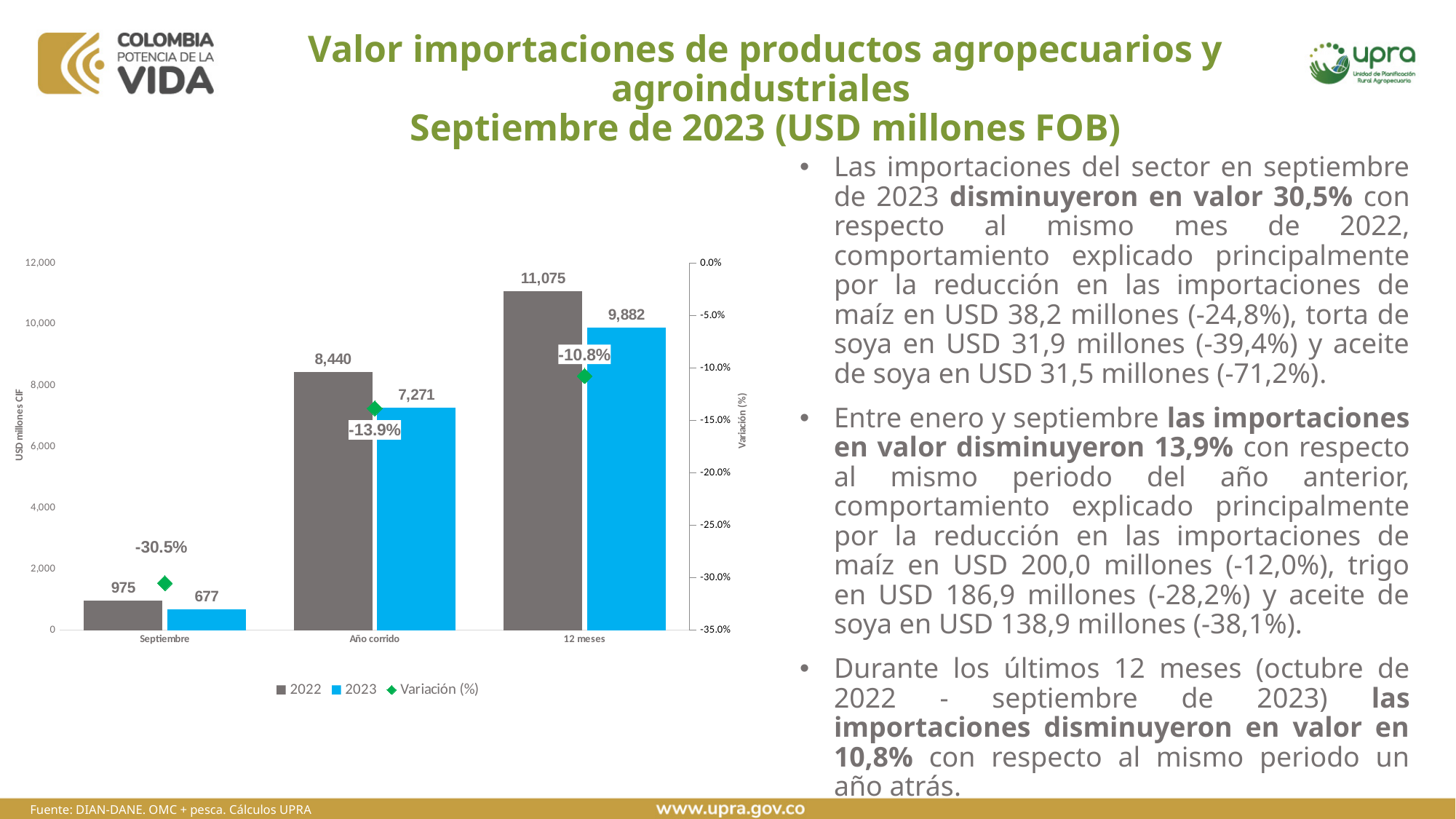
What is the difference between the 2022 and 2023 values for Año corrido? 1,169 Which category has the highest 2023 value? 12 meses What is the Variación (%) shown for Septiembre? -30.5% What kind of chart is shown on the slide? Bar chart What is the 2022 value for 12 meses? 11,075 Which is larger for 12 meses, the 2022 value or the 2023 value? 2022 What is the 2022 value for Septiembre? 975 Which category has the lowest 2022 value? Septiembre How many categories are shown on the x axis? 3 What is the 2023 value for Año corrido? 7,271 What is the Variación (%) shown for 12 meses? -10.8% How many series does the legend list? 3